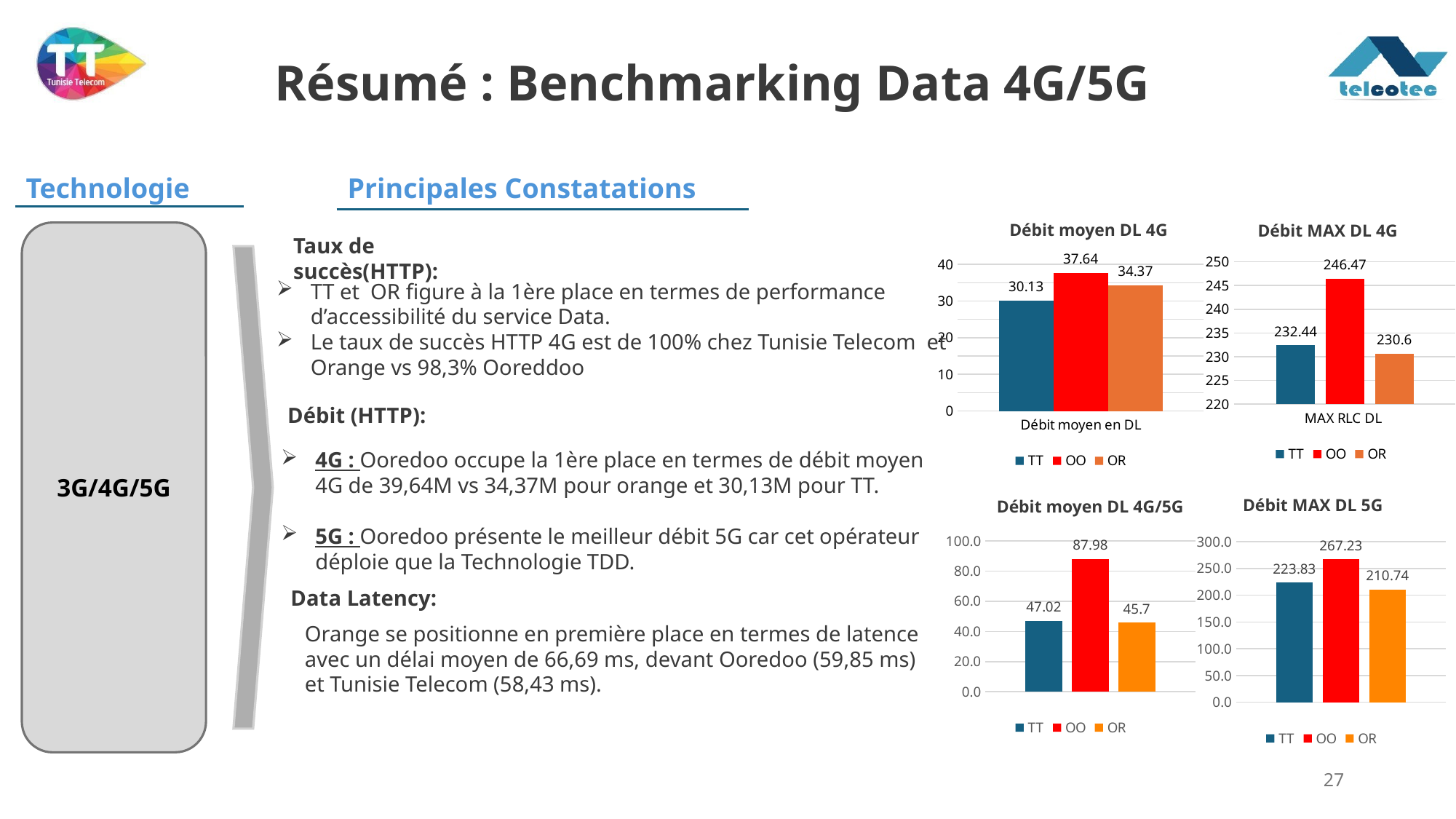
In the 'Débit MAX DL 5G' chart, which is larger, the value for TT or the value for OR? TT In the 'Débit MAX DL 4G' chart, what is the difference between the OO and OR values? 15.87 In the 'Débit moyen DL 4G' chart, what is the value for OO? 37.64 How many series does the legend of the 'Débit MAX DL 5G' chart list? 3 In the 'Débit MAX DL 5G' chart, what is the value for OO? 267.23 What kind of chart is the 'Débit moyen DL 4G/5G' chart? Bar chart In the 'Débit MAX DL 4G' chart, what is the value for TT? 232.44 In the 'Débit moyen DL 4G/5G' chart, what is the value for OR? 45.7 In the 'Débit MAX DL 4G' chart, which series has the highest value? OO In the 'Débit moyen DL 4G/5G' chart, is the value for OO greater or less than 80.0? greater In the 'Débit moyen DL 4G' chart, which series has the lowest value? TT In the 'Débit moyen DL 4G' chart, what is the difference between the OO and TT values? 7.51